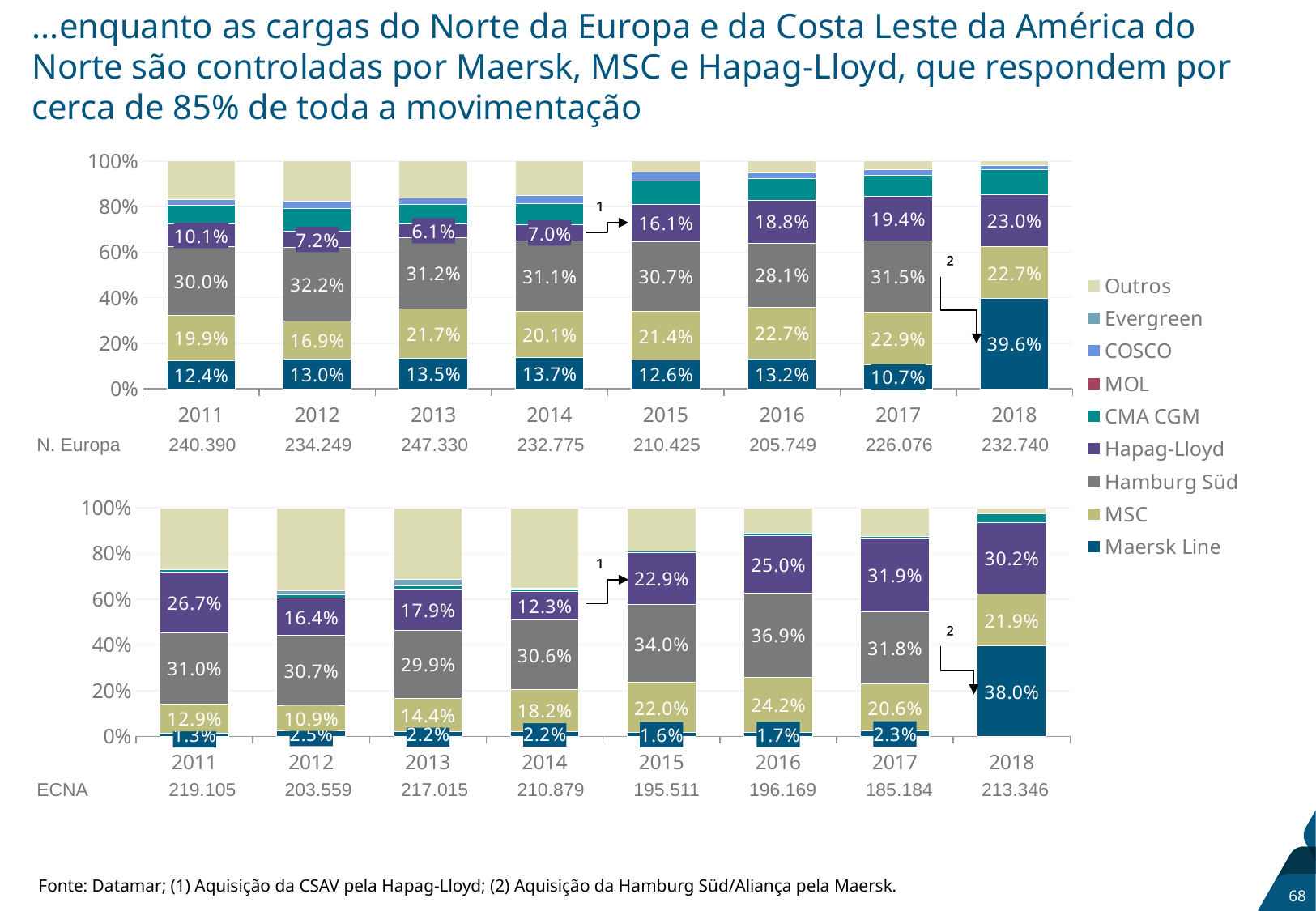
In the bottom chart (ECNA), what is the Hamburg Süd share in 2016? 36.9% In the bottom chart (ECNA), does the MSC share rise or fall from 2011 to 2016? Rises How many series does the legend list? 9 In the bottom chart (ECNA), what is the difference between the Hapag-Lloyd share in 2017 and in 2011? 5.2 percentage points In the top chart (N. Europa), in 2016, which is larger: the MSC share or the Hapag-Lloyd share? MSC In the bottom chart (ECNA), in which year is the Maersk Line share lowest? 2011 In the top chart (N. Europa), in which year is the Hapag-Lloyd share lowest? 2013 In the top chart (N. Europa), which year has the highest Maersk Line share? 2018 What is the N. Europa volume shown below the top chart for 2015? 210.425 In the top chart (N. Europa), what is the Hapag-Lloyd share in 2018? 23.0% What kind of chart is the top chart (N. Europa)? Stacked bar chart How many years are shown on the x axis of the bottom chart (ECNA)? 8